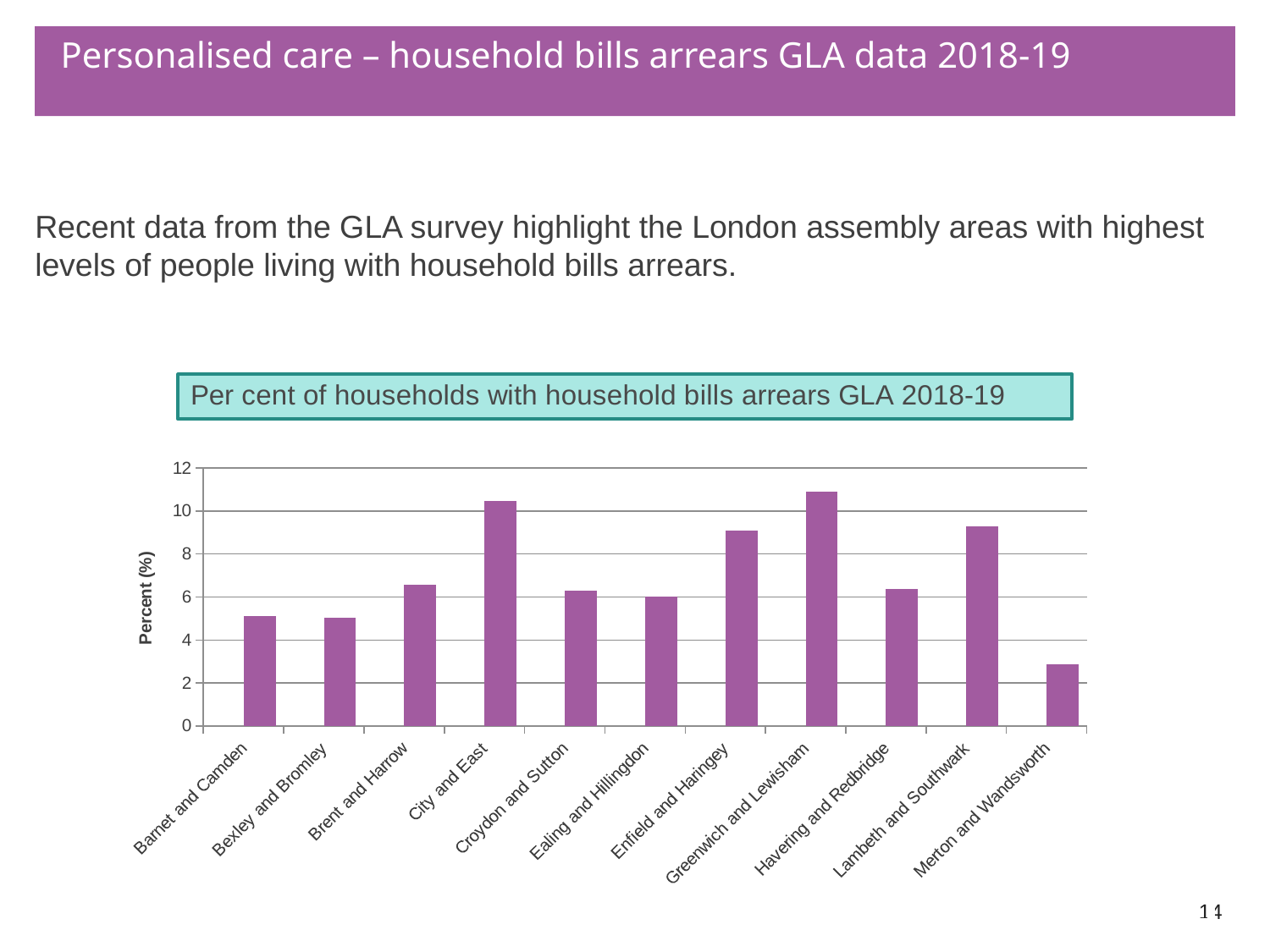
What is the label on the y axis of the chart? Percent (%) Which area has the lowest per cent of households with household bills arrears? Merton and Wandsworth Is the value for Merton and Wandsworth greater or less than 4? less Is the value for Enfield and Haringey greater or less than 8? greater What is the title of the chart? Per cent of households with household bills arrears GLA 2018-19 Is the value for City and East greater or less than 10? greater Which is larger, the value for City and East or the value for Barnet and Camden? City and East What kind of chart is shown on the slide? Bar chart How many London assembly areas are shown on the x axis of the chart? 11 Which area has the highest per cent of households with household bills arrears? Greenwich and Lewisham Which is larger, the value for Lambeth and Southwark or the value for Havering and Redbridge? Lambeth and Southwark